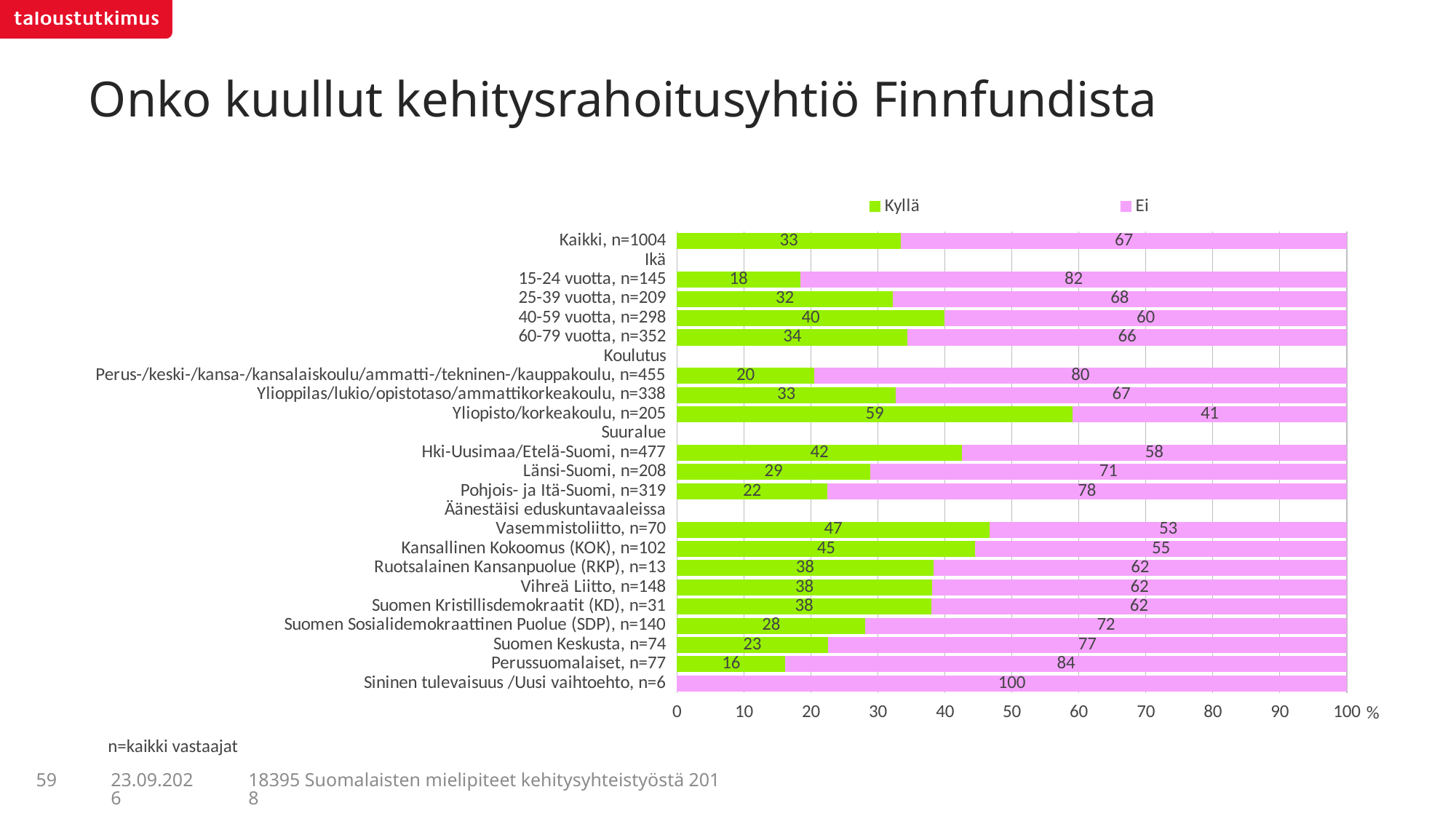
Is the Kyllä value for Hki-Uusimaa/Etelä-Suomi, n=477 greater or less than 40? greater What is the Ei value for the 15-24 vuotta age group? 82 How many series does the legend list? 2 Which category has the highest Kyllä value? Yliopisto/korkeakoulu, n=205 What percentage of all respondents (Kaikki, n=1004) answered Kyllä? 33 What is the total of the stacked bar for Perussuomalaiset, n=77? 100 What is the Kyllä value for Yliopisto/korkeakoulu, n=205? 59 What is the difference between the Ei and Kyllä values for Kaikki, n=1004? 34 Which category has the lowest Ei value? Yliopisto/korkeakoulu, n=205 What kind of chart is shown on the slide? Stacked bar chart Which category has the highest Ei value? Sininen tulevaisuus /Uusi vaihtoehto, n=6 Which has a larger Kyllä value: Vasemmistoliitto, n=70 or Kansallinen Kokoomus (KOK), n=102? Vasemmistoliitto, n=70